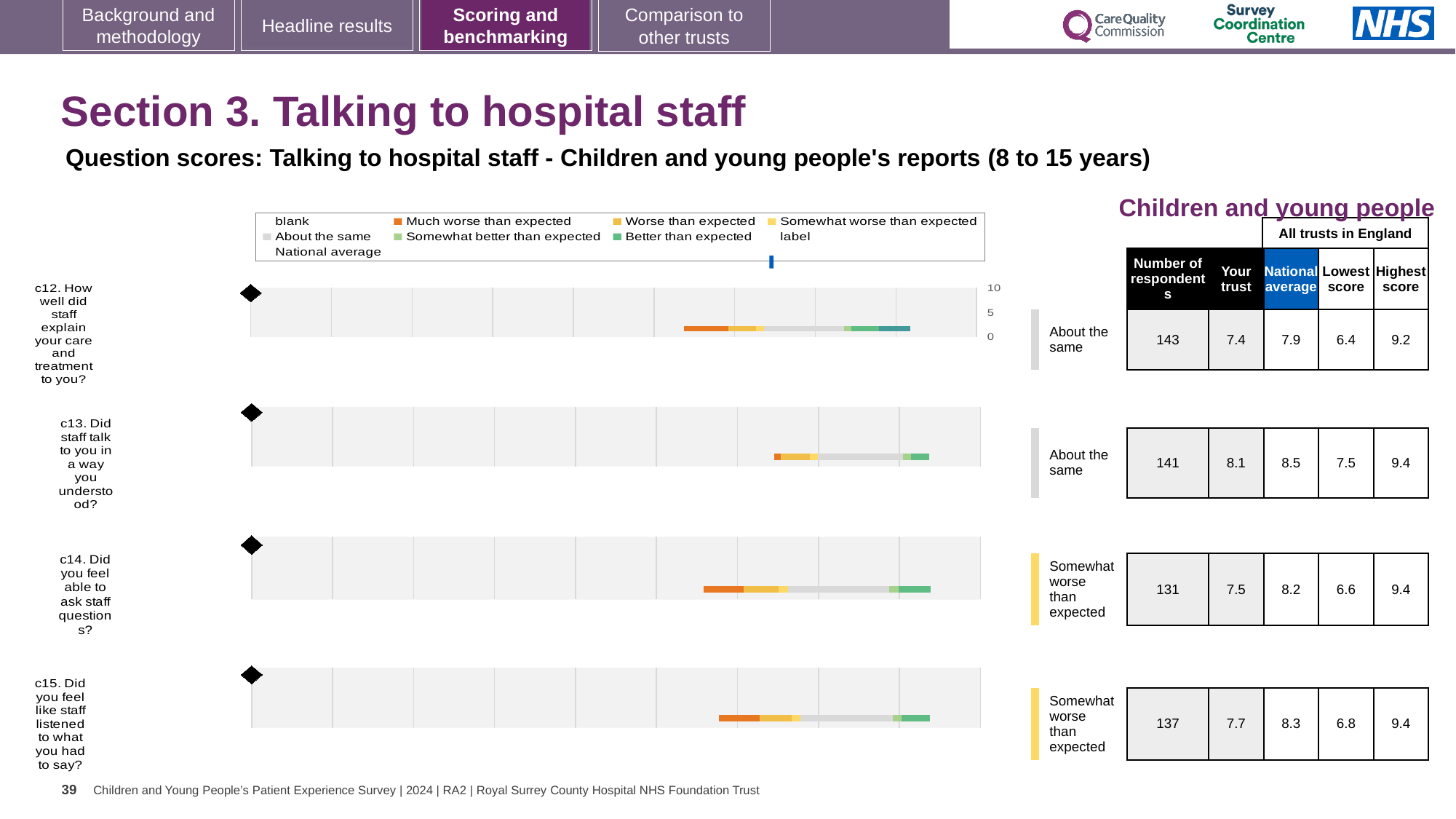
For c14 (Did you feel able to ask staff questions?), what is the national average score? 8.2 For c15, which is larger: the 'Your trust' score or the national average? National average For c13 (Did staff talk to you in a way you understood?), how many respondents are there? 141 For c12, what is the lowest score among all trusts in England? 6.4 How many question charts are shown on the slide? 4 Which question has the highest 'Your trust' score? c13. Did staff talk to you in a way you understood? Which question has the lowest 'Your trust' score? c12. How well did staff explain your care and treatment to you? For c14, what is the difference between the national average and the 'Your trust' score? 0.7 What kind of chart is used for each question (c12 to c15)? Bar chart For c12 (How well did staff explain your care and treatment to you?), what is the 'Your trust' score? 7.4 For c15 (Did you feel like staff listened to what you had to say?), what is the highest score among all trusts in England? 9.4 What benchmark category is shown for c14 (Did you feel able to ask staff questions?)? Somewhat worse than expected